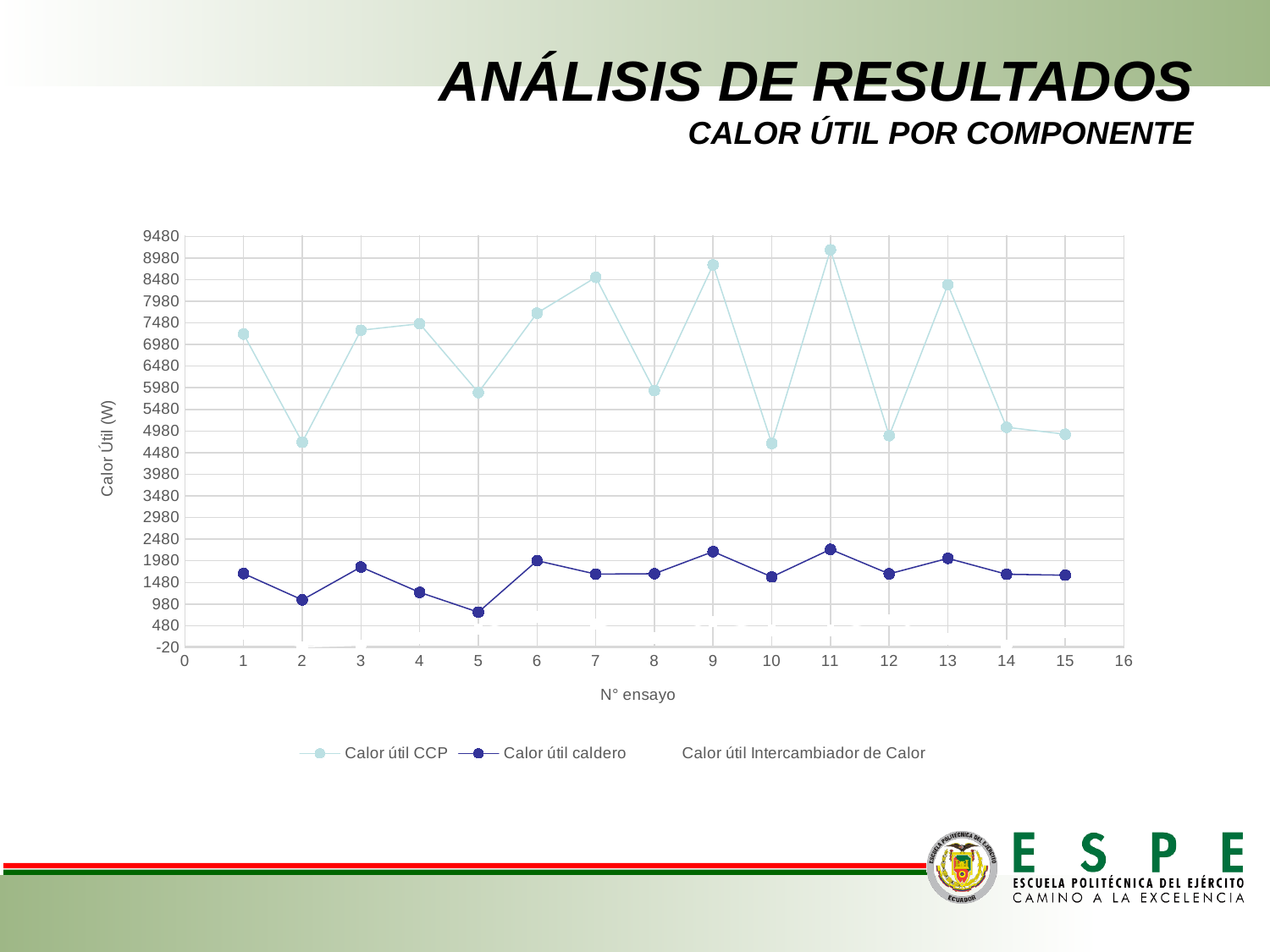
How many data points does the Calor útil CCP series have? 15 What kind of chart is shown on the slide? Line chart At which N° ensayo does Calor útil caldero reach its lowest value? 5 What is the title of the vertical axis? Calor Útil (W) Is the value of Calor útil caldero at ensayo 5 greater or less than 980? less Is the value of Calor útil CCP at ensayo 11 greater or less than 8980? greater At which N° ensayo does Calor útil CCP reach its highest value? 11 At ensayo 1, which series has the larger value, Calor útil CCP or Calor útil caldero? Calor útil CCP Does Calor útil caldero rise or fall from ensayo 5 to ensayo 6? Rise Is the value of Calor útil CCP at ensayo 2 greater or less than 4980? less Which is larger, Calor útil CCP at ensayo 9 or at ensayo 8? Ensayo 9 How many series does the legend list? 3